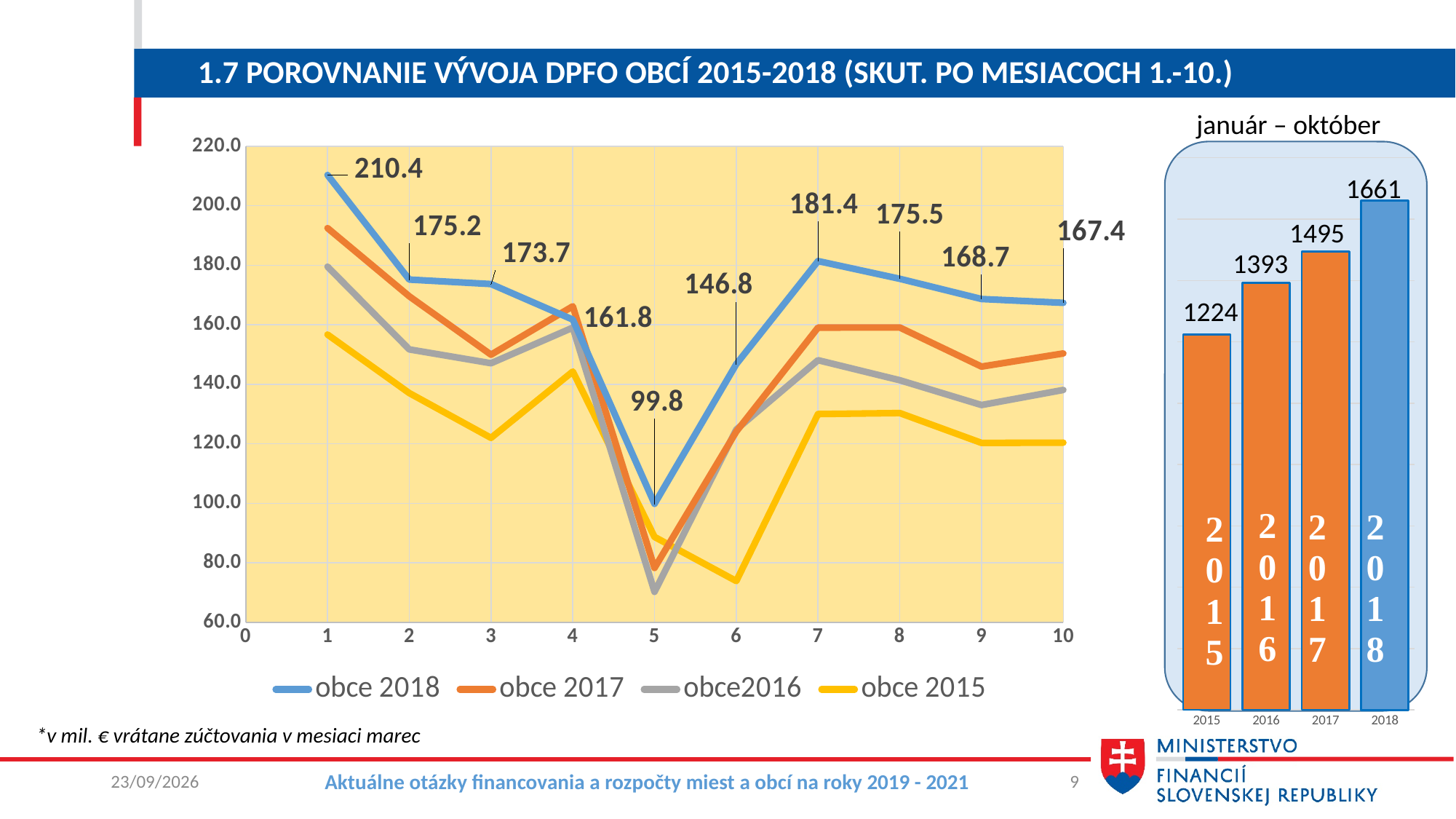
In the line chart on the left, which series has the larger value in month 7, obce 2018 or obce 2015? obce 2018 In the bar chart titled 'január – október', what is the difference between the values for 2018 and 2015? 437 What kind of chart is the chart on the left? line chart In the bar chart titled 'január – október', do the values rise or fall from 2015 to 2018? rise In the bar chart titled 'január – október', which year has the highest value? 2018 How many series does the legend of the line chart on the left list? 4 In the line chart on the left, what is the value for obce 2018 in month 1? 210.4 In the line chart on the left, in which month is the obce 2018 value lowest? 5 In the bar chart titled 'január – október', what is the value for 2018? 1661 In the line chart on the left, is the value for obce 2017 in month 5 greater or less than 100? less In the line chart on the left, what is the difference between the obce 2018 values in month 1 and month 10? 43.0 In the line chart on the left, what is the value for obce 2018 in month 5? 99.8